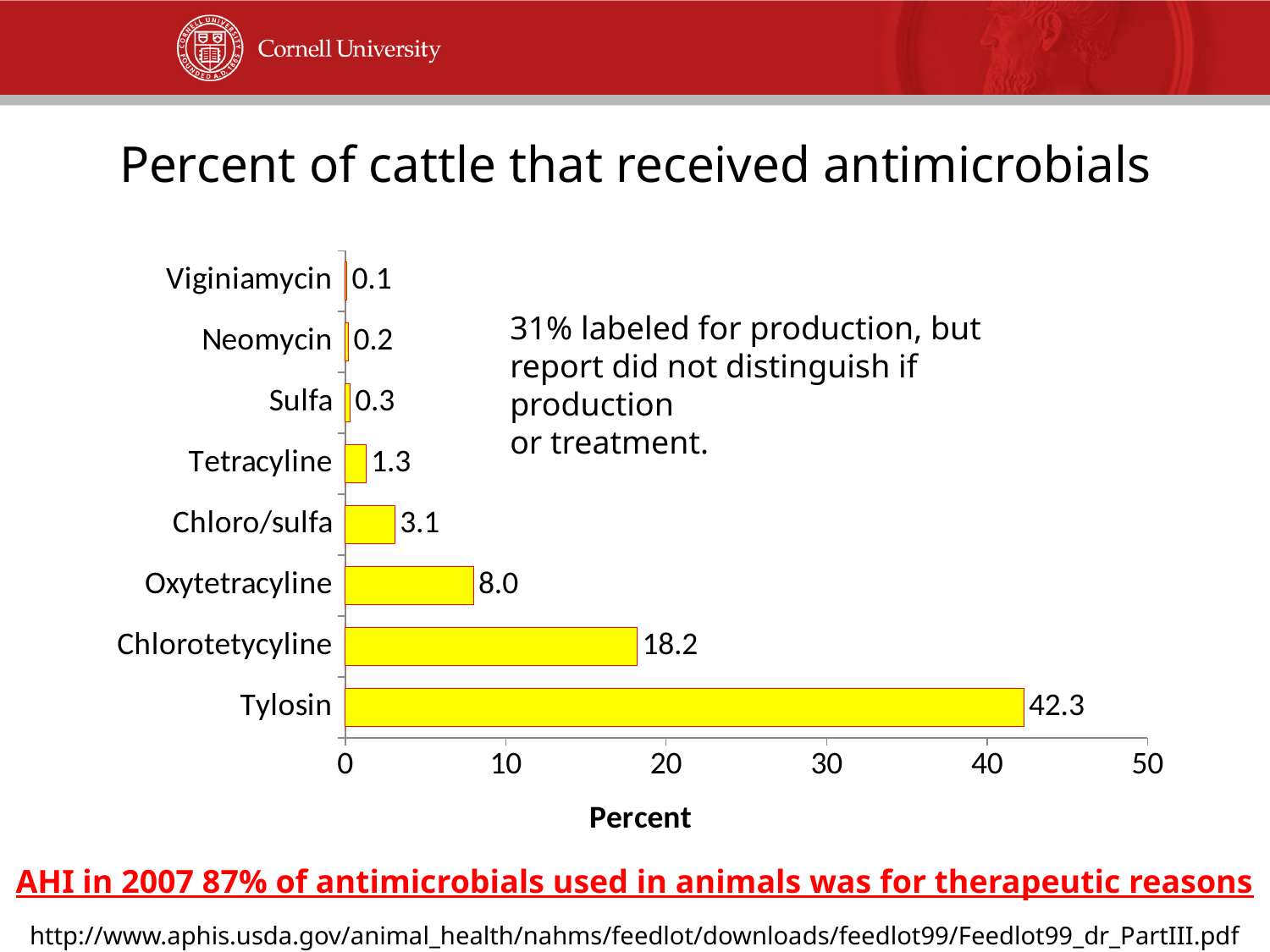
What is the difference between the values for Tylosin and Chlorotetycyline? 24.1 Is the value for Tylosin greater or less than 40? greater How many antimicrobials are shown in the chart? 8 What is the difference between the values for Oxytetracyline and Tetracyline? 6.7 What is the value shown for Chloro/sulfa? 3.1 What is the label of the horizontal axis? Percent Which antimicrobial has the highest percent of cattle receiving it? Tylosin Which antimicrobial has the lowest percent of cattle receiving it? Viginiamycin What percent of cattle received Tylosin? 42.3 What is the value shown for Oxytetracyline? 8.0 What kind of chart is shown on the slide? bar chart Which has a larger value, Chlorotetycyline or Oxytetracyline? Chlorotetycyline